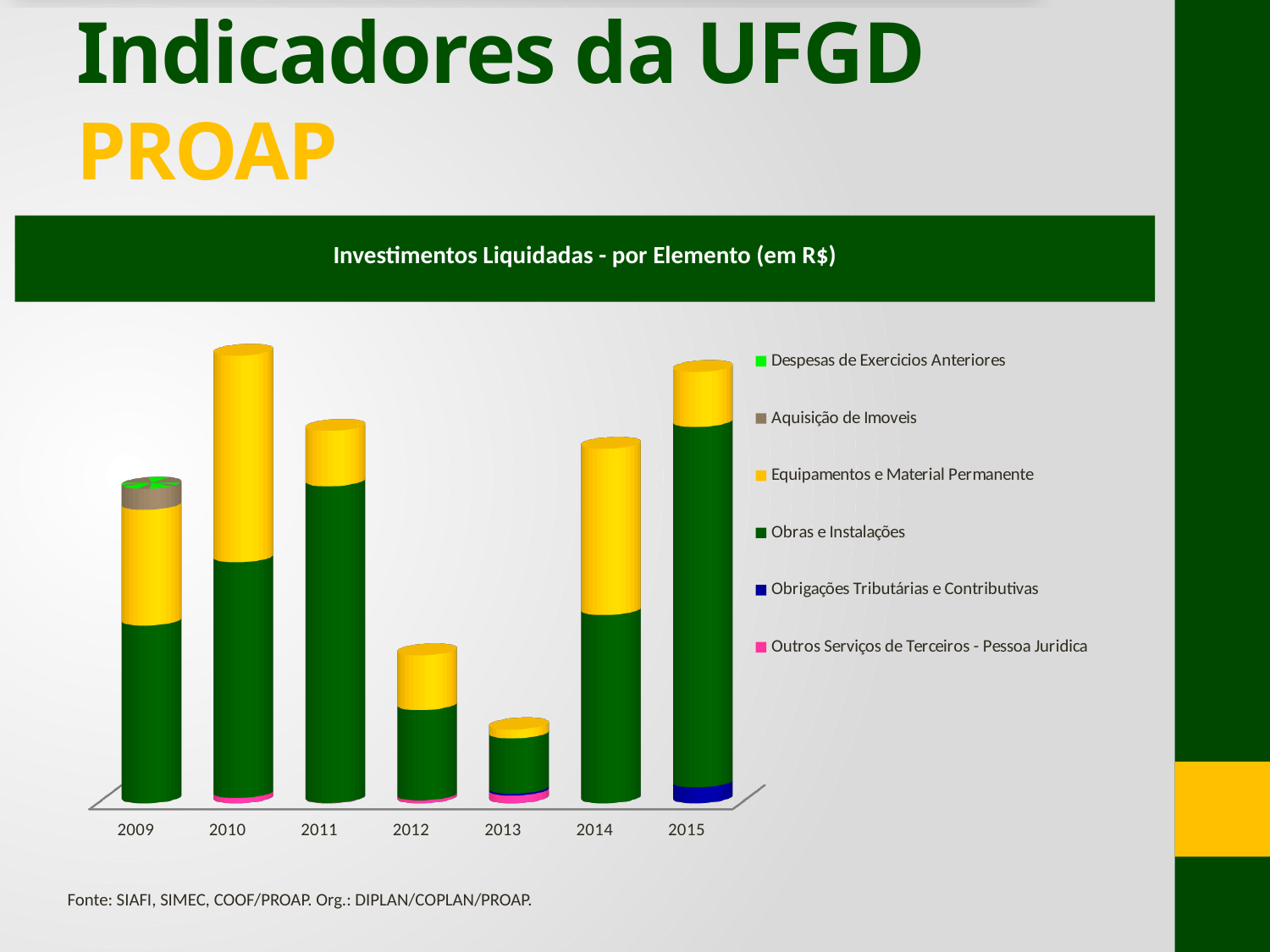
Which year has the larger total bar, 2012 or 2013? 2012 What is the title of the chart? Investimentos Liquidadas - por Elemento (em R$) Which year has the largest Obras e Instalações segment? 2015 How many series does the chart legend list? 6 Which year has the largest Equipamentos e Material Permanente segment? 2010 Which year has the larger total bar, 2009 or 2011? 2011 How many years are shown on the x axis of the chart? 7 Which year has the shortest stacked bar? 2013 Which year has the tallest stacked bar? 2010 What kind of chart is shown on the slide? Stacked bar chart Which year is the only one with an Aquisição de Imoveis segment? 2009 Do the total bar heights rise or fall from 2010 to 2013? Fall